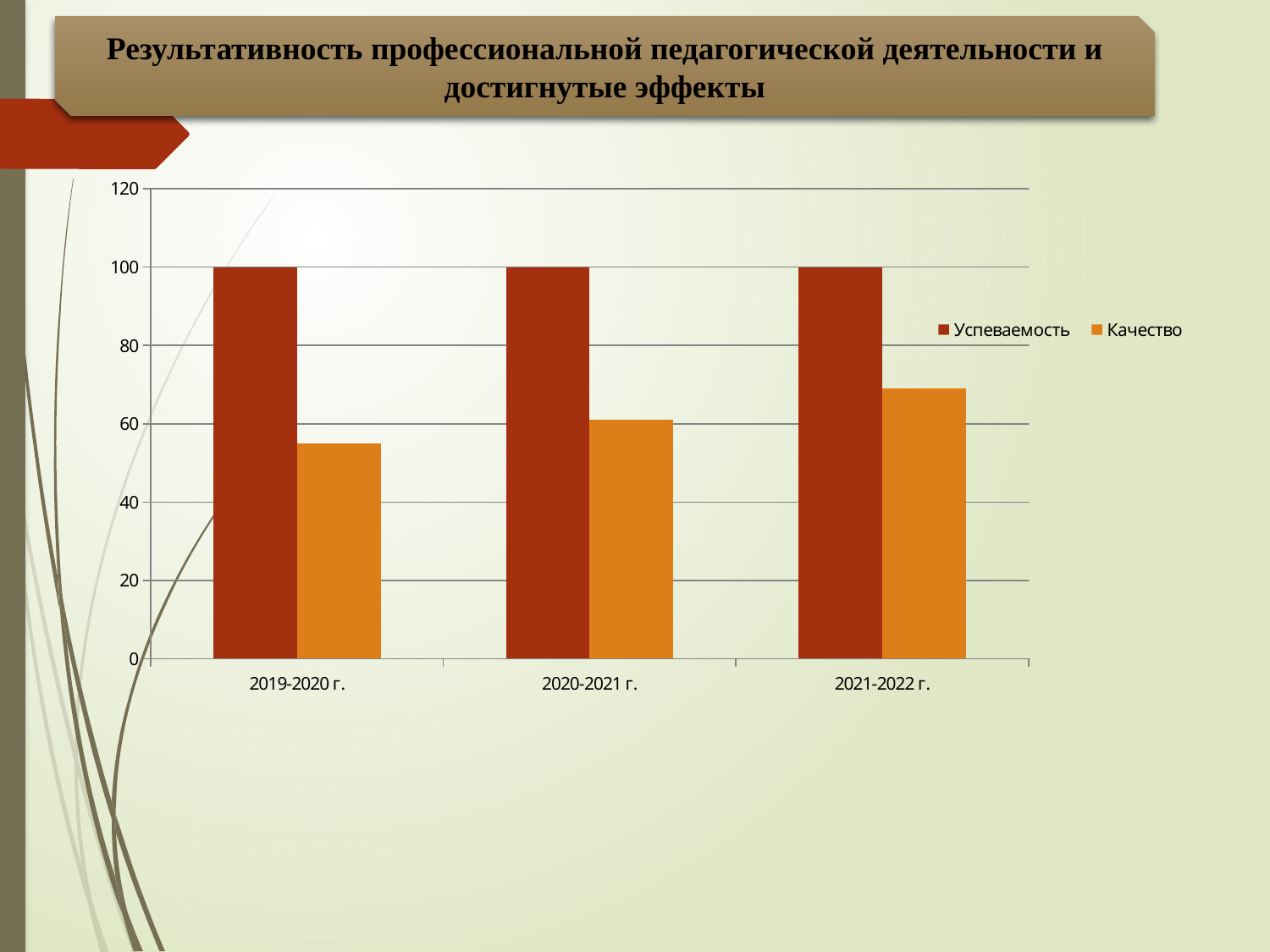
Which year has the lowest value of Качество? 2019-2020 г. What kind of chart is shown on the slide? bar chart Which year has the highest value of Качество? 2021-2022 г. Do the values of Качество rise or fall from 2019-2020 г. to 2021-2022 г.? rise What is the value of Успеваемость for 2019-2020 г.? 100 How many categories are shown on the x axis? 3 What is the value of Успеваемость for 2021-2022 г.? 100 Is the value of Качество for 2021-2022 г. greater or less than 80? less How many series does the legend list? 2 Which is larger for 2020-2021 г.: Успеваемость or Качество? Успеваемость Is the value of Качество for 2019-2020 г. greater or less than 60? less